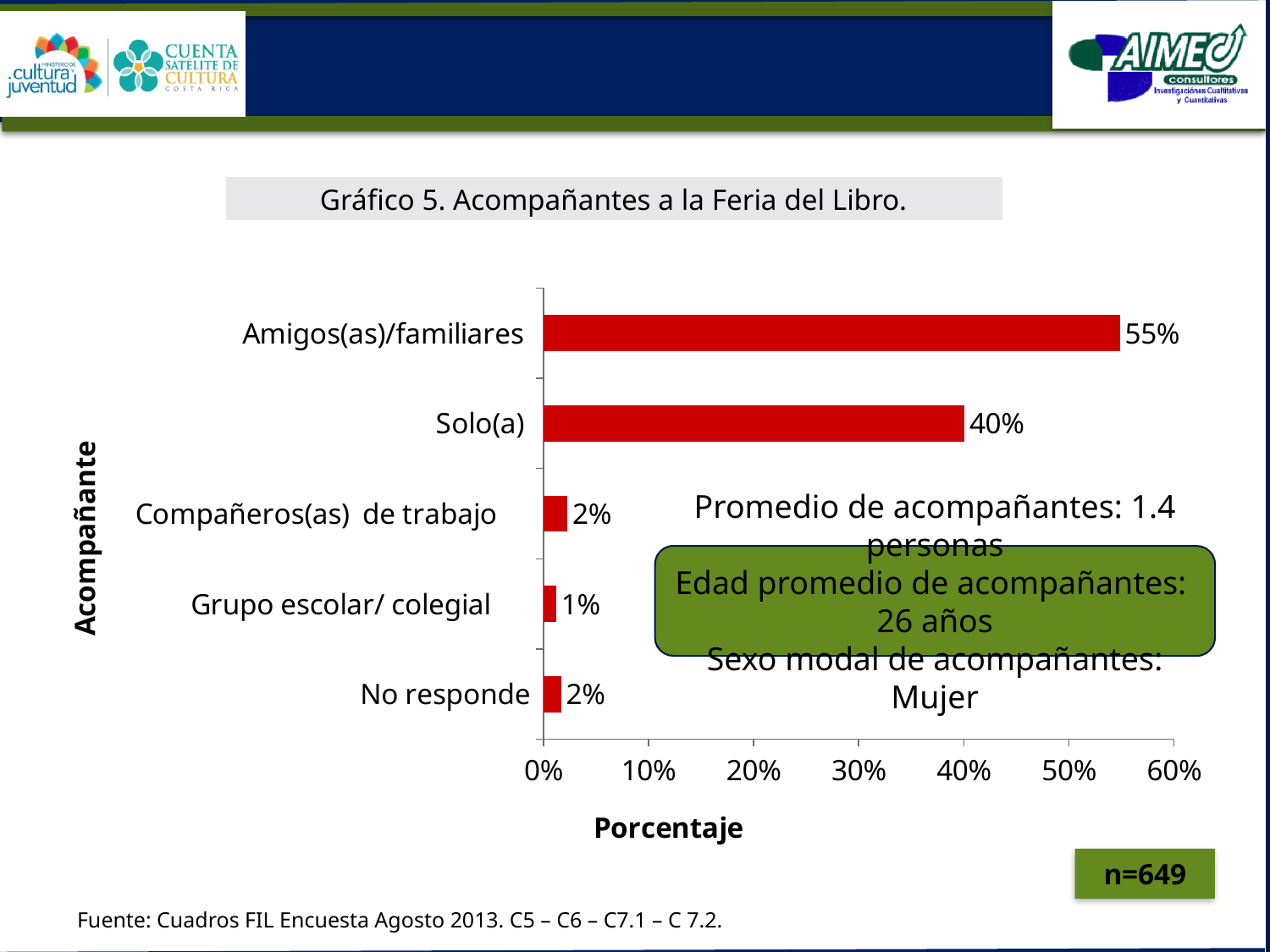
What is the value for Grupo escolar/ colegial? 1% What is the value for Solo(a)? 40% What kind of chart is shown? bar chart What is the value for Amigos(as)/familiares? 55% What is the value for Compañeros(as) de trabajo? 2% Which is larger, the value for Solo(a) or the value for No responde? Solo(a) Which category has the lowest value? Grupo escolar/ colegial How many categories are shown in the chart? 5 Is the value for Amigos(as)/familiares greater or less than 50%? greater What is the title of the chart? Gráfico 5. Acompañantes a la Feria del Libro. Which category has the highest value? Amigos(as)/familiares What is the difference between the values for Amigos(as)/familiares and Solo(a)? 15%